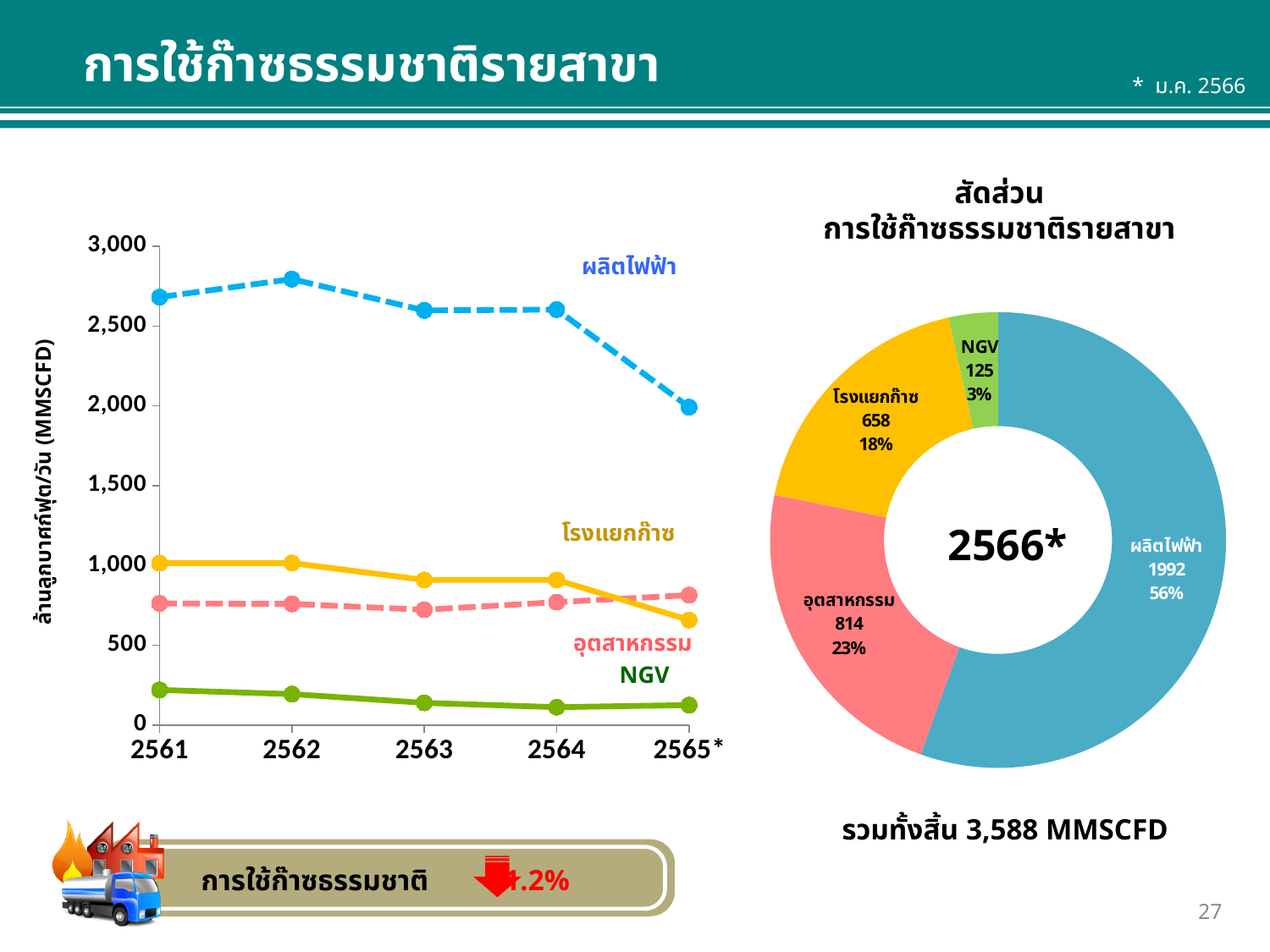
On the line chart on the left, does the NGV line rise or fall from 2561 to 2565*? Falls On the donut chart on the right, what is the value for ผลิตไฟฟ้า? 1992 On the donut chart on the right, what share of natural gas use does อุตสาหกรรม account for? 23% On the line chart on the left, is the value for ผลิตไฟฟ้า in 2561 greater or less than 2,500? greater On the donut chart on the right, which sector has the largest share? ผลิตไฟฟ้า What kind of chart is the chart on the left of the slide? Line chart What is the total natural gas use stated below the donut chart on the right? 3,588 MMSCFD On the donut chart on the right, which sector has the smallest share? NGV On the line chart on the left, in 2561 which is larger, โรงแยกก๊าซ or อุตสาหกรรม? โรงแยกก๊าซ On the donut chart on the right, what is the value for โรงแยกก๊าซ? 658 On the donut chart on the right, what is the difference between the values for ผลิตไฟฟ้า and อุตสาหกรรม? 1178 On the donut chart on the right, how many sectors are shown? 4